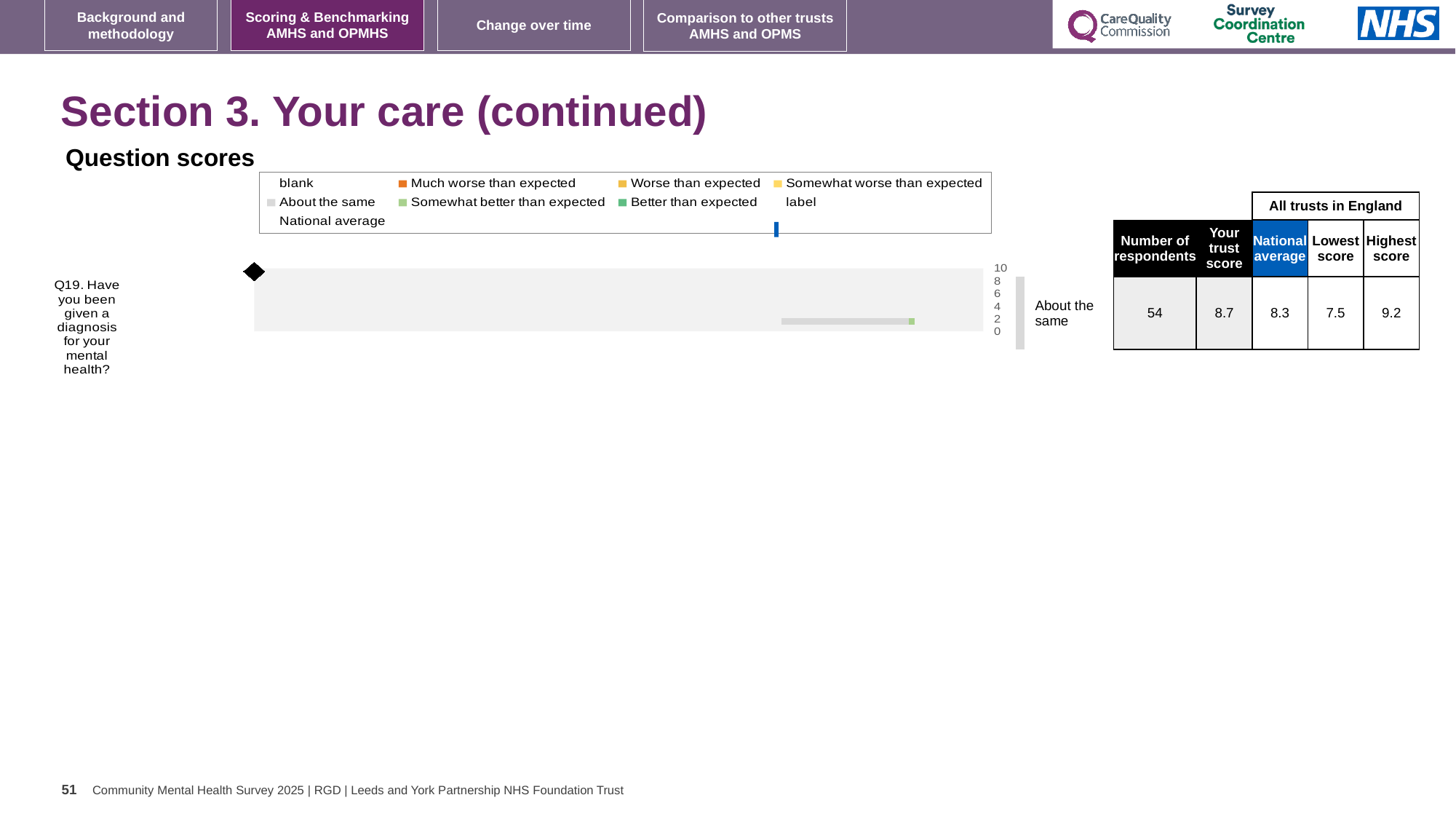
Which is larger for Q19, the trust score or the national average? trust score Which question is shown in the Question scores chart? Q19. Have you been given a diagnosis for your mental health? What is the trust score for Q19? 8.7 What is the number of respondents for Q19? 54 What kind of chart is shown under 'Question scores'? bar chart What is the difference between the highest and lowest scores for Q19? 1.7 What is the lowest score among all trusts in England for Q19? 7.5 How many survey questions are plotted in the Question scores chart? 1 What rating label is shown next to the bar for Q19? About the same What is the national average score for Q19? 8.3 What is the highest value shown on the chart's axis? 10 What is the highest score among all trusts in England for Q19? 9.2